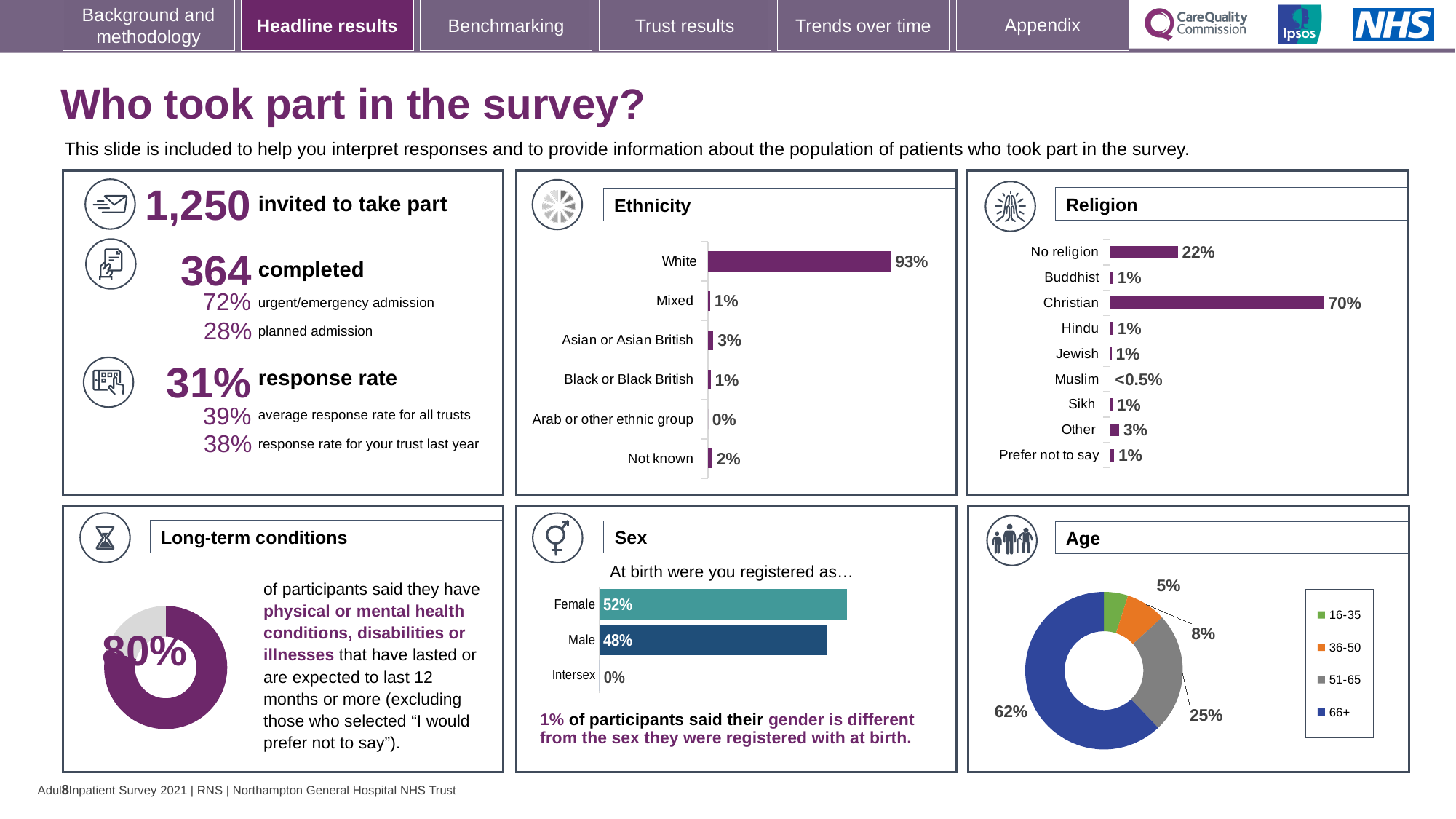
In the Religion chart, what is the difference between the Christian and No religion values? 48 percentage points In the Religion chart, how many religion categories are listed? 9 In the Ethnicity chart, what is the value for Asian or Asian British? 3% In the Ethnicity chart, which category has the highest value? White In the Ethnicity chart, how many ethnicity categories are shown? 6 In the Ethnicity chart, what percentage of participants were White? 93% In the Age chart, what share of participants were aged 66+? 62% What kind of chart is the Age chart? Doughnut (pie) chart In the Religion chart, what is the value shown for Muslim? <0.5% In the Religion chart, what percentage of participants were Christian? 70% In the Sex chart, which is larger, the Female or the Male value? Female In the Sex chart, what is the difference between the Female and Male values? 4 percentage points